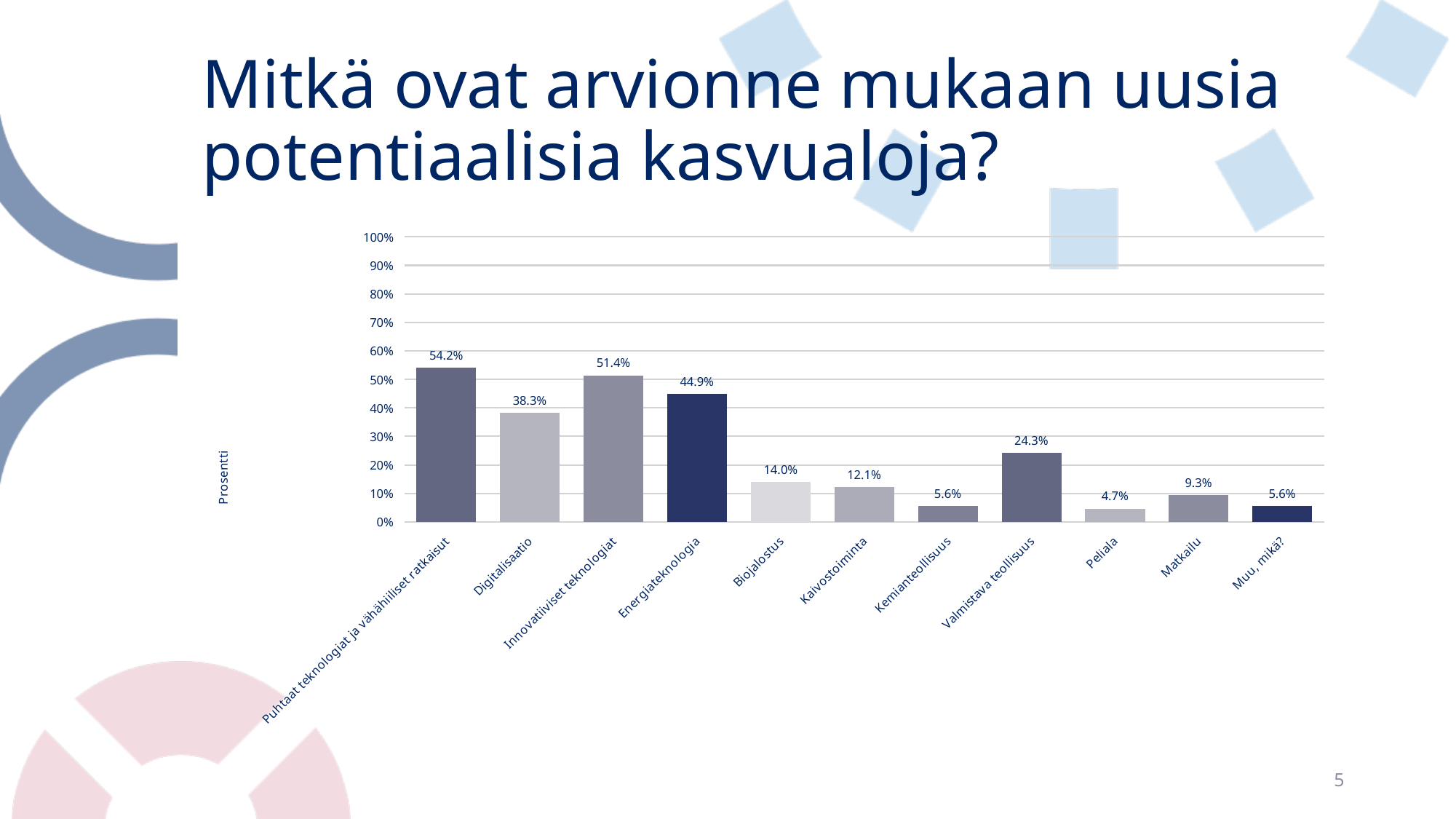
Which category has the highest value? Puhtaat teknologiat ja vähähiiliset ratkaisut What is the value for Energiateknologia? 44.9% Is the value for Matkailu greater or less than 10%? less What is the value for Valmistava teollisuus? 24.3% How many categories are shown on the x axis? 11 What is the value for Digitalisaatio? 38.3% What kind of chart is shown on the slide? bar chart What is the label of the y axis? Prosentti Which is larger, the value for Biojalostus or the value for Kaivostoiminta? Biojalostus What is the difference between the values for Puhtaat teknologiat ja vähähiiliset ratkaisut and Digitalisaatio? 15.9% What is the difference between the values for Innovatiiviset teknologiat and Energiateknologia? 6.5% Which category has the lowest value? Peliala